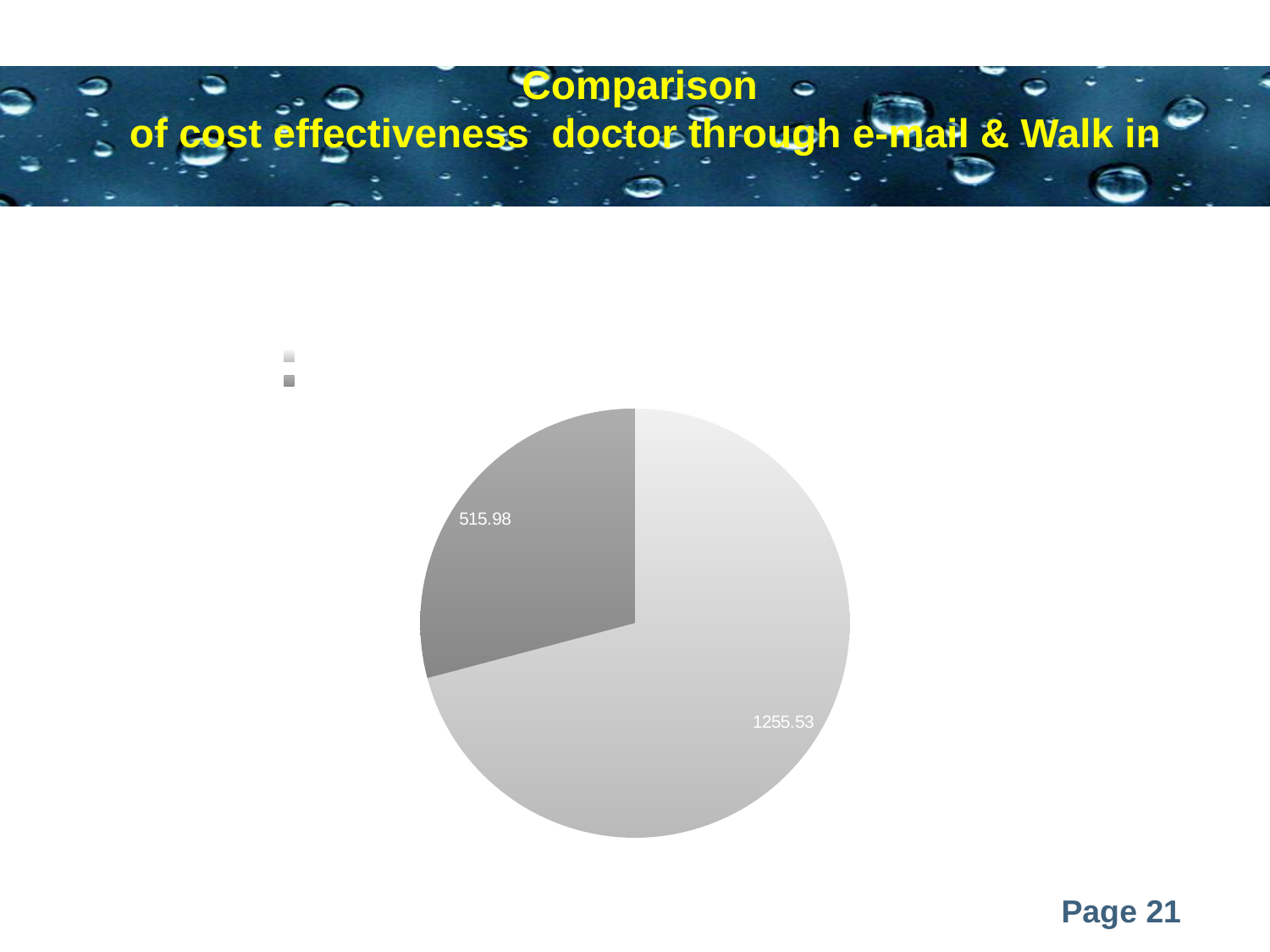
What is the title of the slide containing the pie chart? Comparison of cost effectiveness doctor through e-mail & Walk in What is the value printed on the smaller, darker slice of the pie chart? 515.98 What is the value of the smallest slice in the pie chart? 515.98 Is the darker slice of the pie chart larger or smaller than the lighter slice? smaller What is the total of the two slice values in the pie chart? 1771.51 How many entries does the legend of the pie chart show? 2 What is the difference between the two slice values in the pie chart? 739.55 What is the value printed on the larger, lighter slice of the pie chart? 1255.53 What kind of chart is shown on the slide? pie chart How many slices does the pie chart have? 2 What share of the pie does the slice labelled 1255.53 represent, to one decimal place? 70.9% What is the value of the largest slice in the pie chart? 1255.53